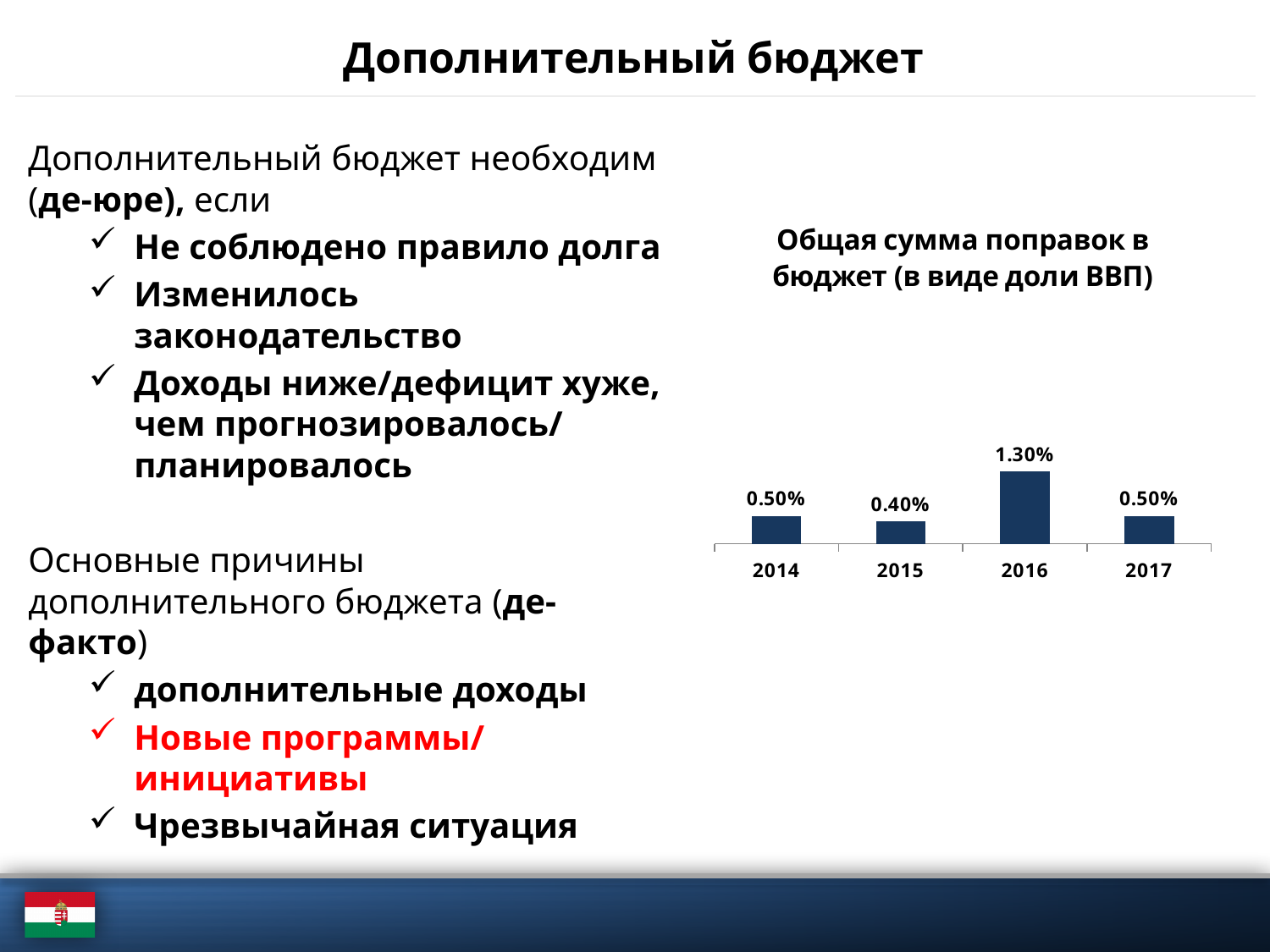
What is the value for 2015? 0.40% What is the value for 2017? 0.50% Which year has the highest value? 2016 Do the values rise or fall from 2015 to 2016? Rise Which is larger, the value for 2016 or the value for 2017? 2016 What is the title of the chart? Общая сумма поправок в бюджет (в виде доли ВВП) What is the value for 2014? 0.50% What is the value for 2016? 1.30% What is the difference between the values for 2016 and 2015? 0.90% How many years are shown on the chart? 4 Which year has the lowest value? 2015 What kind of chart is shown on the slide? Bar chart